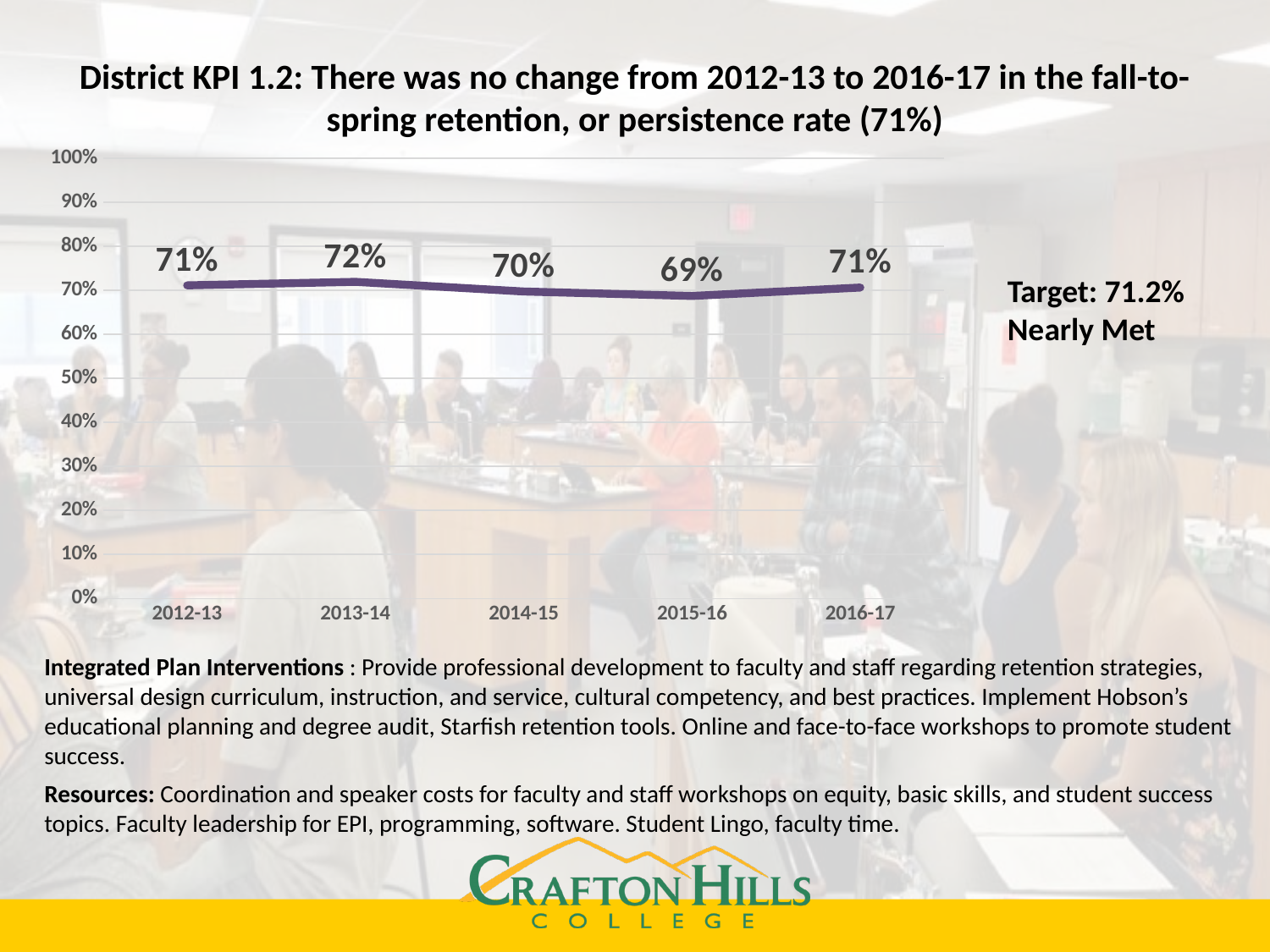
What is the retention rate shown for 2016-17? 71% How many years are plotted on the chart? 5 What is the difference between the retention rate in 2013-14 and in 2015-16? 3% Which year has the highest retention rate? 2013-14 Which year has a higher retention rate, 2014-15 or 2015-16? 2014-15 What is the retention rate shown for 2013-14? 72% What kind of chart is shown on the slide? Line chart What is the retention rate shown for 2015-16? 69% Is the value for 2015-16 greater or less than 60%? greater What target value is stated next to the chart? 71.2% Which year has the lowest retention rate? 2015-16 What is the retention rate shown for 2012-13? 71%